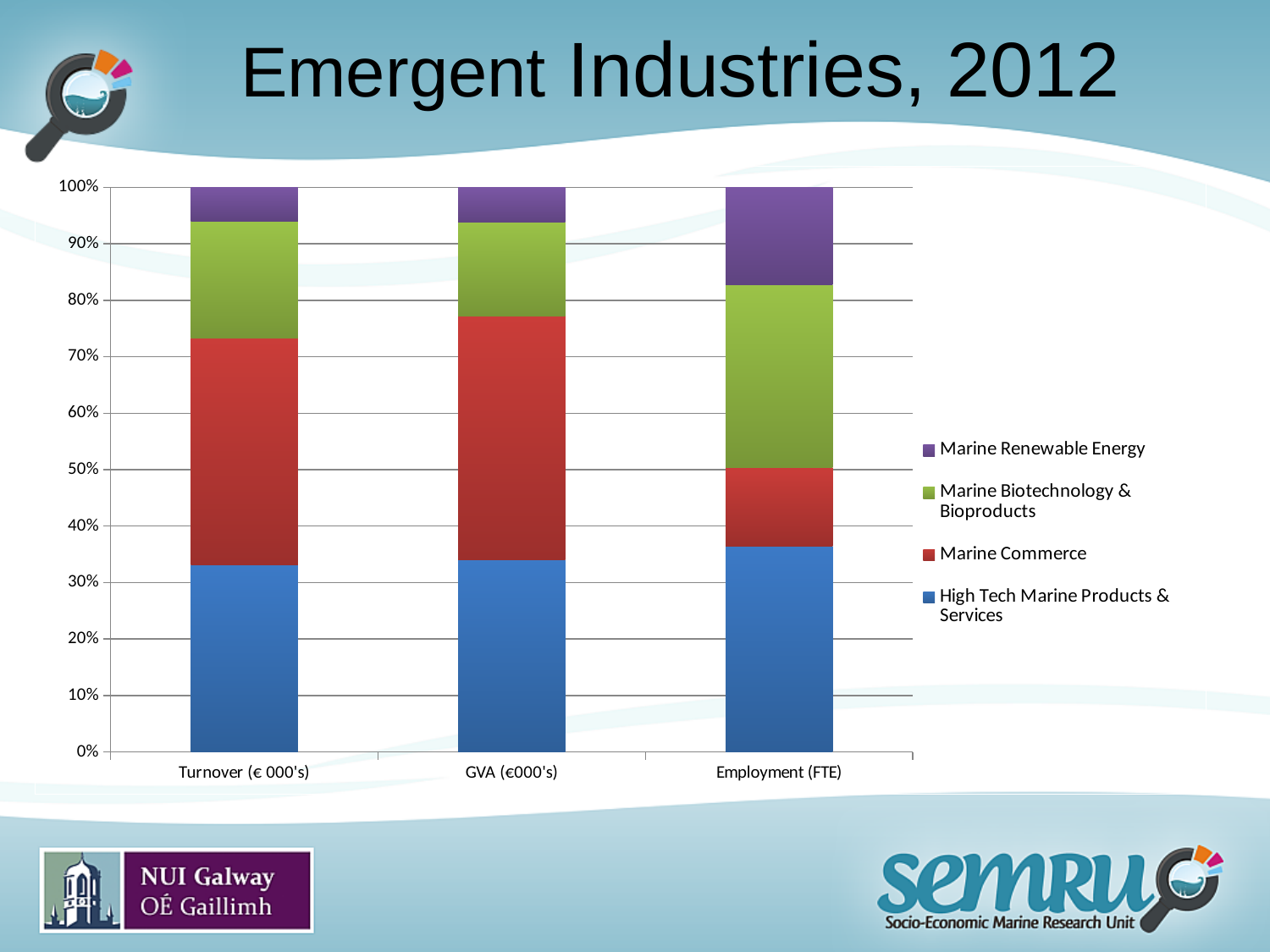
How many series does the chart's legend list? 4 What is the total height of the Employment (FTE) stacked bar? 100% Is the Marine Commerce share of Employment (FTE) greater or less than 20%? less What colour represents Marine Commerce in the chart? Red What kind of chart is shown on the slide? Stacked bar chart Is the Marine Commerce share of Turnover (€ 000's) greater or less than 30%? greater Which category has the largest Marine Renewable Energy share? Employment (FTE) Is the Marine Commerce share larger for Turnover (€ 000's) or for Employment (FTE)? Turnover (€ 000's) Is the Marine Renewable Energy share of Employment (FTE) greater or less than 10%? greater How many categories are shown on the x axis of the chart? 3 Which series has the smallest share in the Turnover (€ 000's) bar? Marine Renewable Energy